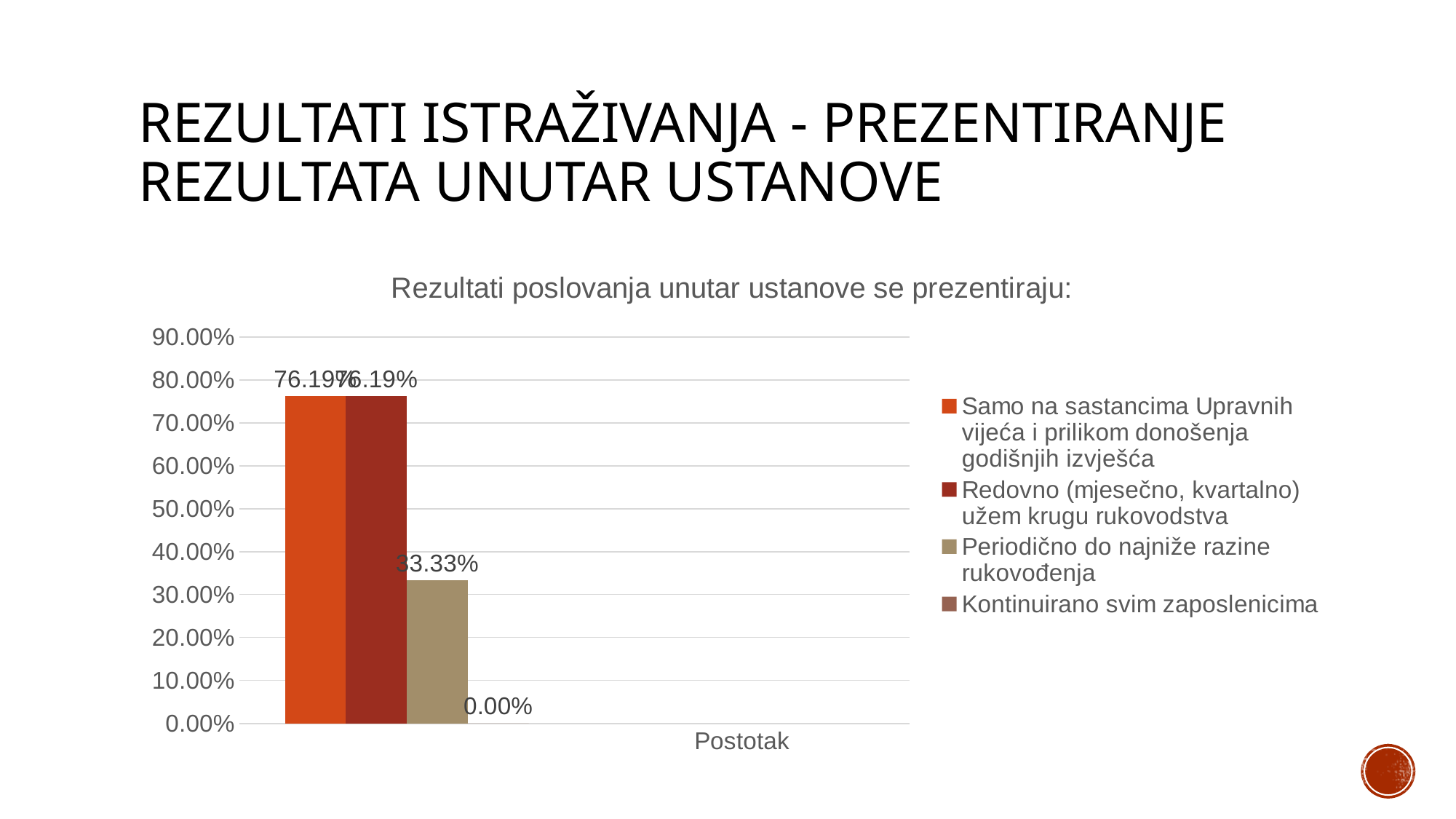
What type of chart is shown on the slide? bar chart What is the value for 'Samo na sastancima Upravnih vijeća i prilikom donošenja godišnjih izvješća'? 76.19% Which is larger: the value for 'Periodično do najniže razine rukovođenja' or the value for 'Kontinuirano svim zaposlenicima'? Periodično do najniže razine rukovođenja What is the title of the chart? Rezultati poslovanja unutar ustanove se prezentiraju: Is the value for 'Periodično do najniže razine rukovođenja' greater or less than 40.00%? less What is the value for 'Redovno (mjesečno, kvartalno) užem krugu rukovodstva'? 76.19% Which series has the lowest value? Kontinuirano svim zaposlenicima How many series does the legend list? 4 What is the value for 'Kontinuirano svim zaposlenicima'? 0.00% What is the difference between the value for 'Redovno (mjesečno, kvartalno) užem krugu rukovodstva' and the value for 'Periodično do najniže razine rukovođenja'? 42.86% What is the value for 'Periodično do najniže razine rukovođenja'? 33.33% What is the label of the category on the x axis? Postotak